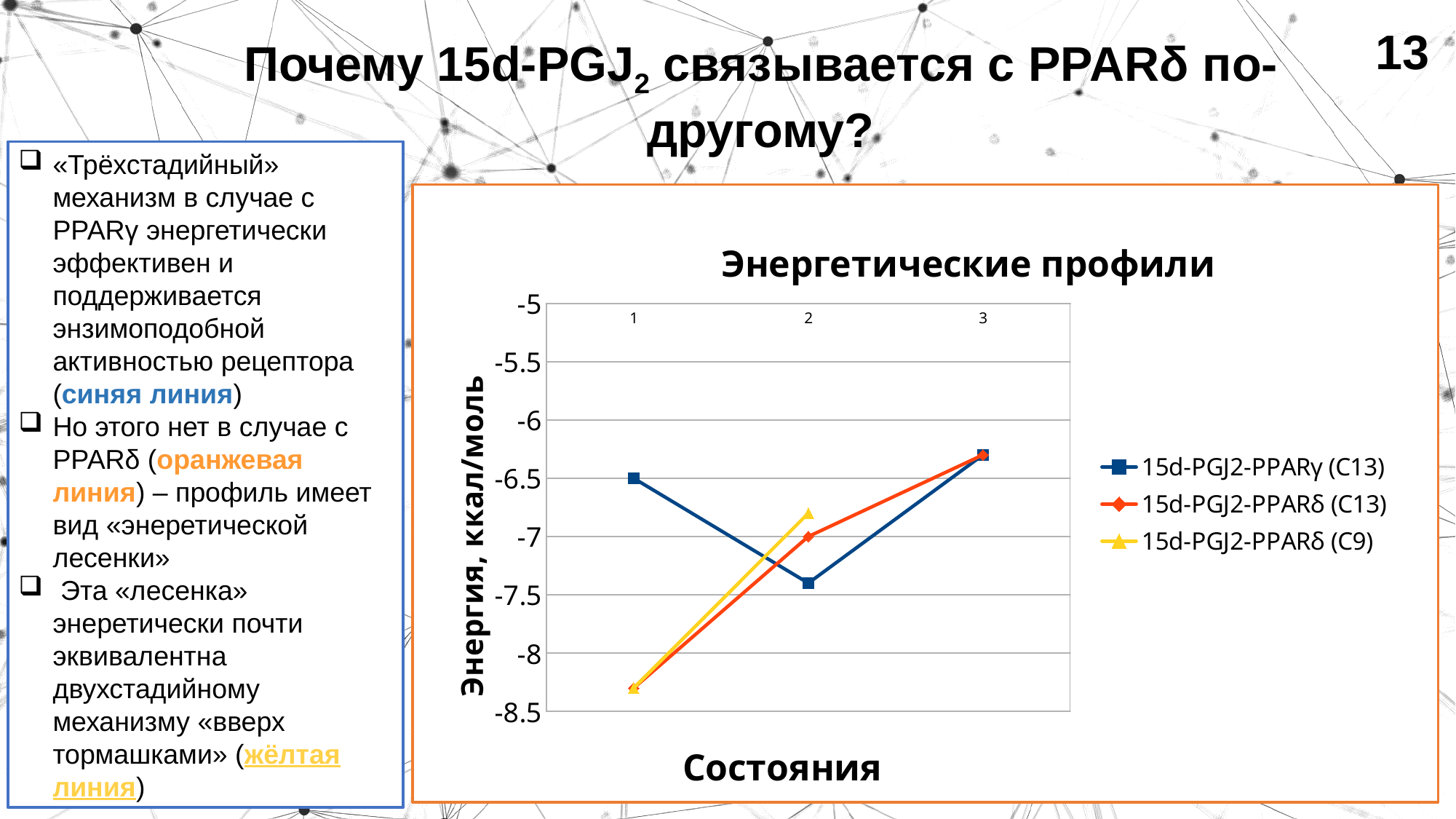
How many states (Состояния) are plotted along the x axis? 3 Is the value of the 15d-PGJ2-PPARδ (C13) series at state 1 greater or less than -8? less What kind of chart is shown on the slide? line chart Does the 15d-PGJ2-PPARδ (C13) series rise or fall from state 1 to state 3? rise What is the value of the 15d-PGJ2-PPARγ (C13) series at state 1? -6.5 What is the title of the chart? Энергетические профили Is the value of the 15d-PGJ2-PPARγ (C13) series at state 2 greater or less than -7? less At state 2, which series has the larger value: 15d-PGJ2-PPARγ (C13) or 15d-PGJ2-PPARδ (C13)? 15d-PGJ2-PPARδ (C13) At which state does the 15d-PGJ2-PPARγ (C13) series reach its lowest value? 2 What is the value of the 15d-PGJ2-PPARδ (C13) series at state 2? -7 How many series does the legend list? 3 Is the value of the 15d-PGJ2-PPARδ (C9) series at state 2 greater or less than -7? greater